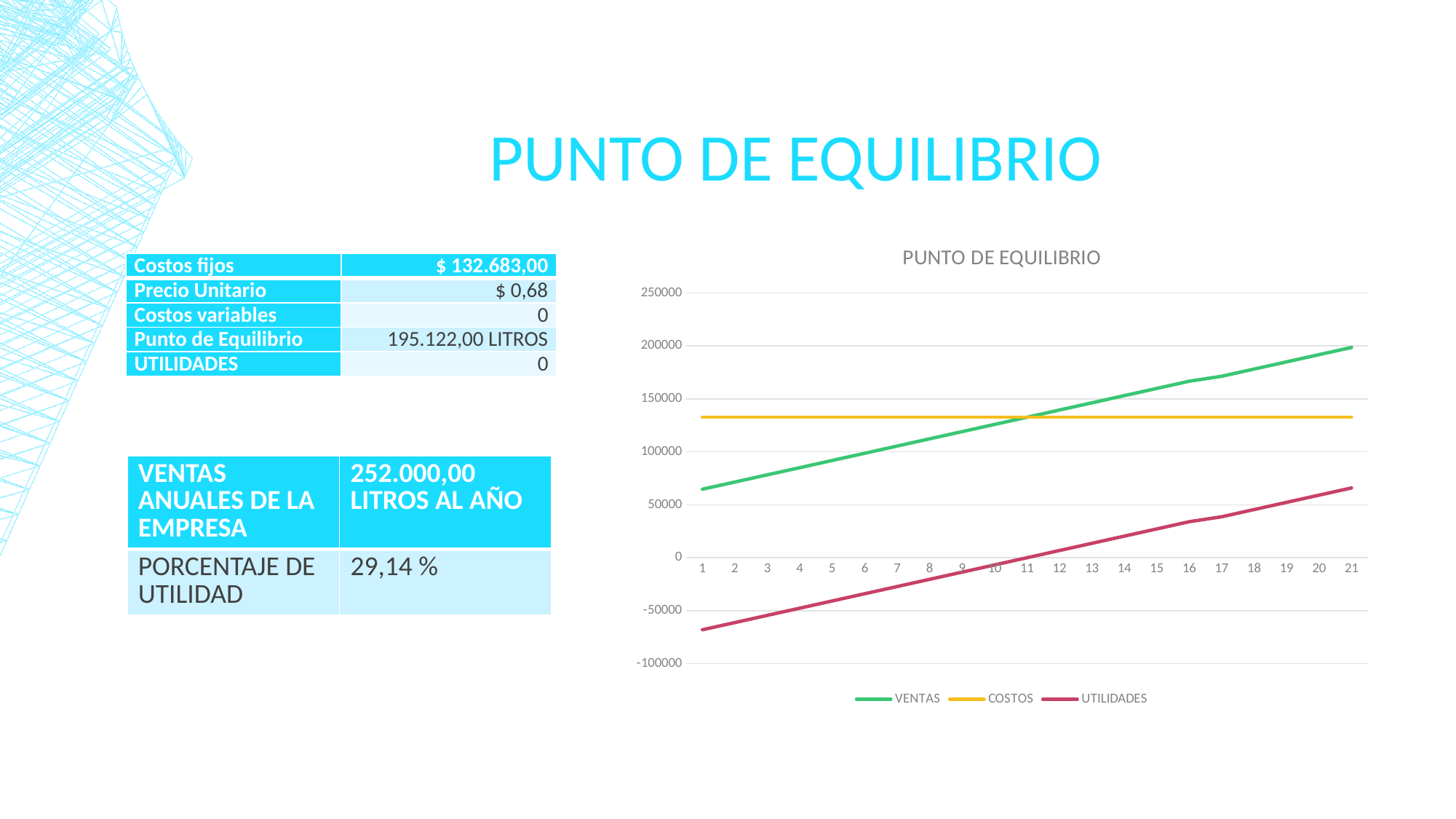
What colour is the COSTOS line in the chart? yellow Is the value of VENTAS at point 21 greater or less than 150000? greater Does the VENTAS line rise or fall from point 1 to point 21? rises At point 21, which is larger, VENTAS or COSTOS? VENTAS At point 1, which series has the lowest value? UTILIDADES Does the UTILIDADES line rise or fall from point 1 to point 21? rises What kind of chart is shown on the slide? line chart How many series does the chart legend list? 3 Is the value of UTILIDADES at point 1 greater or less than -50000? less How many points are plotted along the x axis of the chart? 21 Does the COSTOS line rise, fall or stay flat across the x axis? stays flat Is the value of COSTOS greater or less than 100000? greater